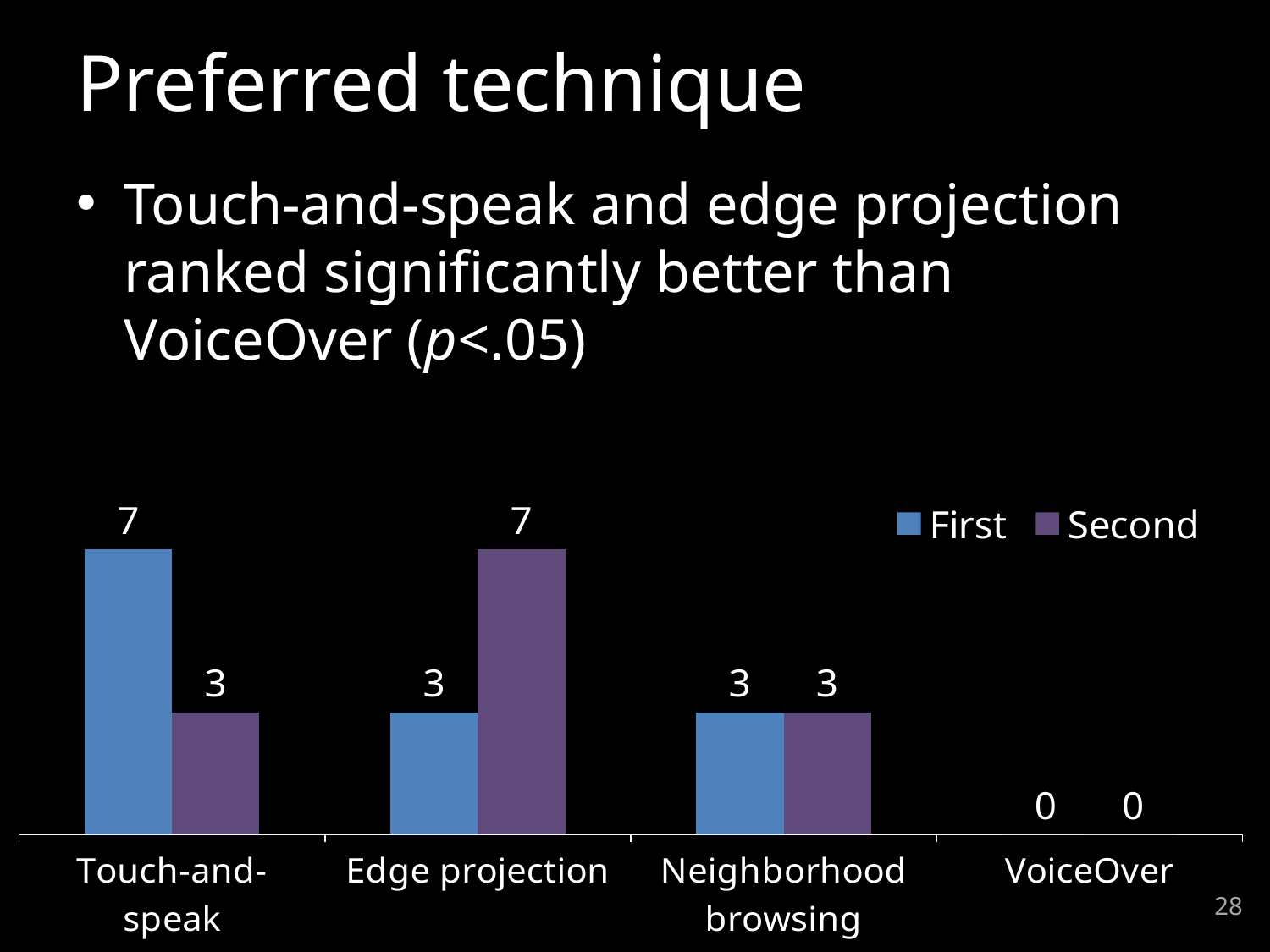
How many categories are shown on the x axis? 4 What kind of chart is shown on the slide? Bar chart What is the value of the Second series for VoiceOver? 0 What is the value of the First series for Touch-and-speak? 7 How many series does the legend list? 2 For Edge projection, which is larger: the First value or the Second value? Second What is the difference between the First and Second values for Touch-and-speak? 4 Which category has the lowest value in the Second series? VoiceOver Which category has the highest value in the First series? Touch-and-speak What is the value of the First series for Neighborhood browsing? 3 What is the value of the Second series for Edge projection? 7 What are the two series names listed in the legend? First and Second